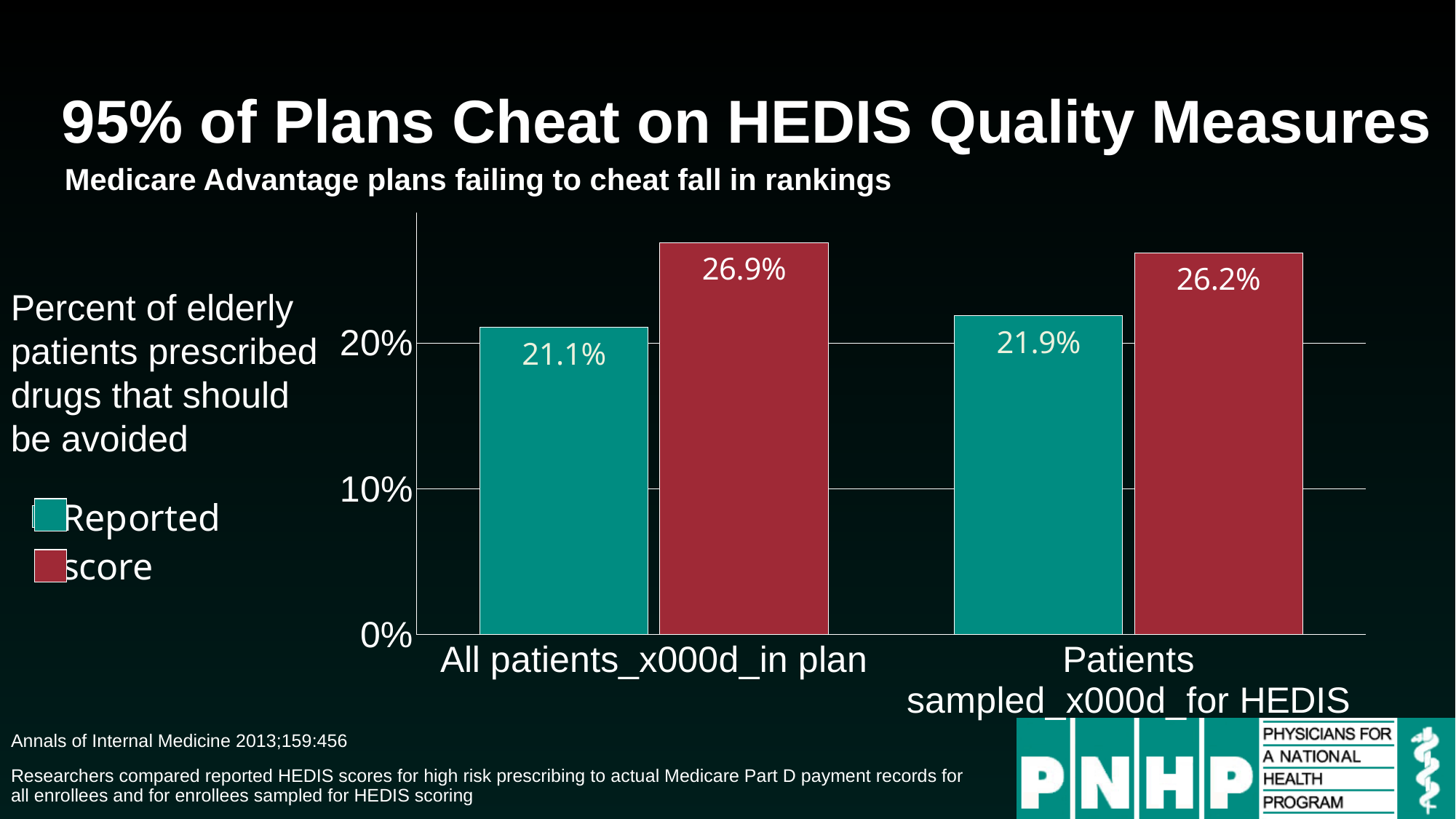
What is the value of the teal bar for the "All patients in plan" category? 21.1% What is the highest value shown on the chart? 26.9% For "All patients in plan", how much higher is the red bar than the teal bar? 5.8 percentage points What is the value of the teal bar for the "Patients sampled for HEDIS" category? 21.9% What kind of chart is shown on the slide? Bar chart For "Patients sampled for HEDIS", how much higher is the red bar than the teal bar? 4.3 percentage points What is the lowest value shown on the chart? 21.1% What is the title of the slide containing the chart? 95% of Plans Cheat on HEDIS Quality Measures How many categories are shown on the x axis of the chart? 2 What is the value of the red bar for the "All patients in plan" category? 26.9% What is the value of the red bar for the "Patients sampled for HEDIS" category? 26.2% Which category has the larger teal bar, "All patients in plan" or "Patients sampled for HEDIS"? Patients sampled for HEDIS